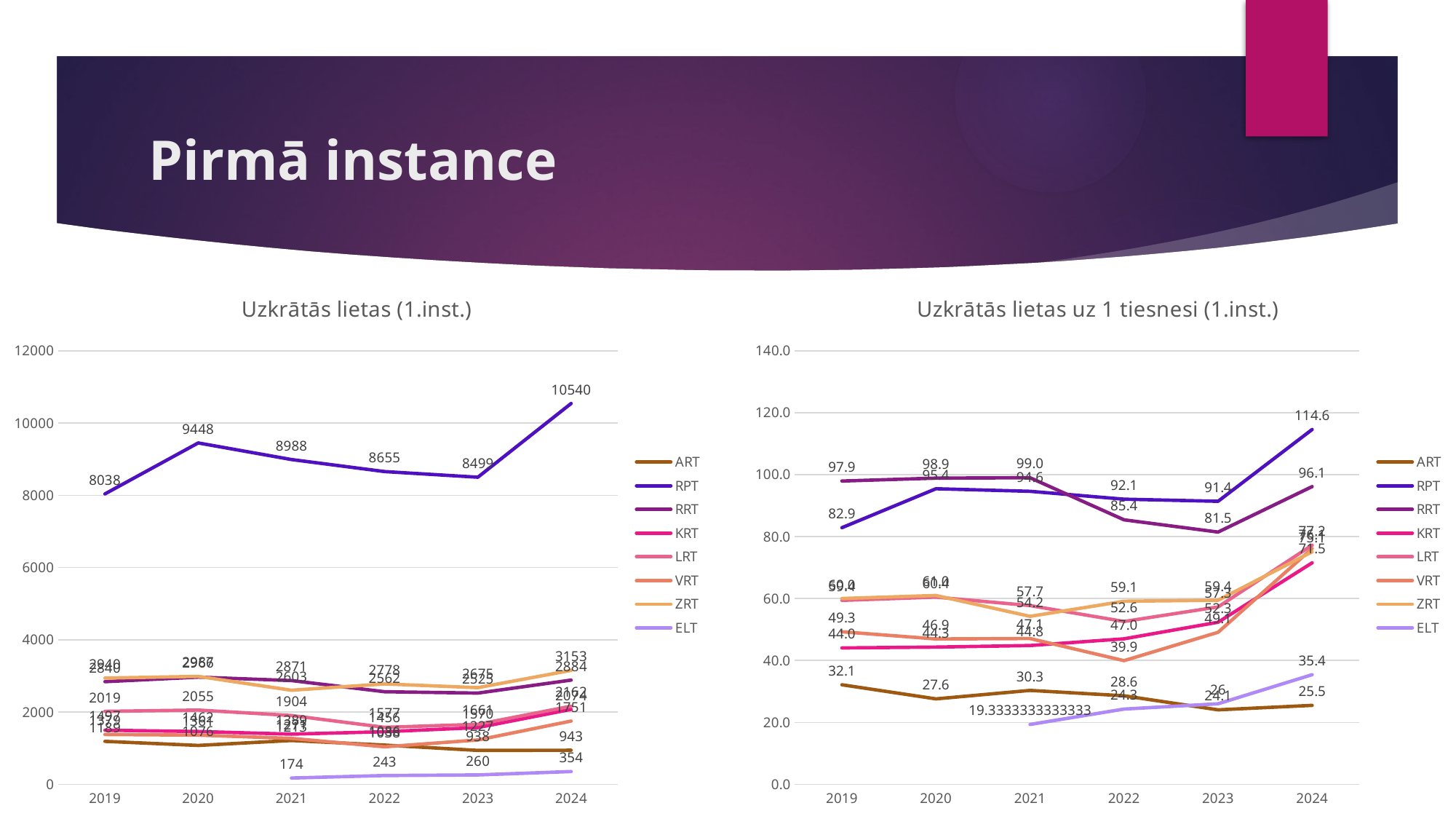
In the left chart 'Uzkrātās lietas (1.inst.)', in which year is the RPT value lowest? 2019 In the left chart 'Uzkrātās lietas (1.inst.)', what is the value for RPT in 2019? 8038 How many years are shown on the x axis of the right chart 'Uzkrātās lietas uz 1 tiesnesi (1.inst.)'? 6 How many series does the legend of the left chart 'Uzkrātās lietas (1.inst.)' list? 8 In the left chart 'Uzkrātās lietas (1.inst.)', what is the value for ELT in 2021? 174 In the right chart 'Uzkrātās lietas uz 1 tiesnesi (1.inst.)', what is the value for RPT in 2024? 114.6 In the left chart 'Uzkrātās lietas (1.inst.)', what is the value for RPT in 2024? 10540 In the right chart 'Uzkrātās lietas uz 1 tiesnesi (1.inst.)', is the value for RPT in 2024 greater or less than 100.0? greater In the right chart 'Uzkrātās lietas uz 1 tiesnesi (1.inst.)', which is larger in 2024, RPT or RRT? RPT In the left chart 'Uzkrātās lietas (1.inst.)', what is the difference between the RPT values for 2024 and 2023? 2041 In the right chart 'Uzkrātās lietas uz 1 tiesnesi (1.inst.)', in which year is the RRT value lowest? 2023 What kind of chart is the left chart, 'Uzkrātās lietas (1.inst.)'? Line chart